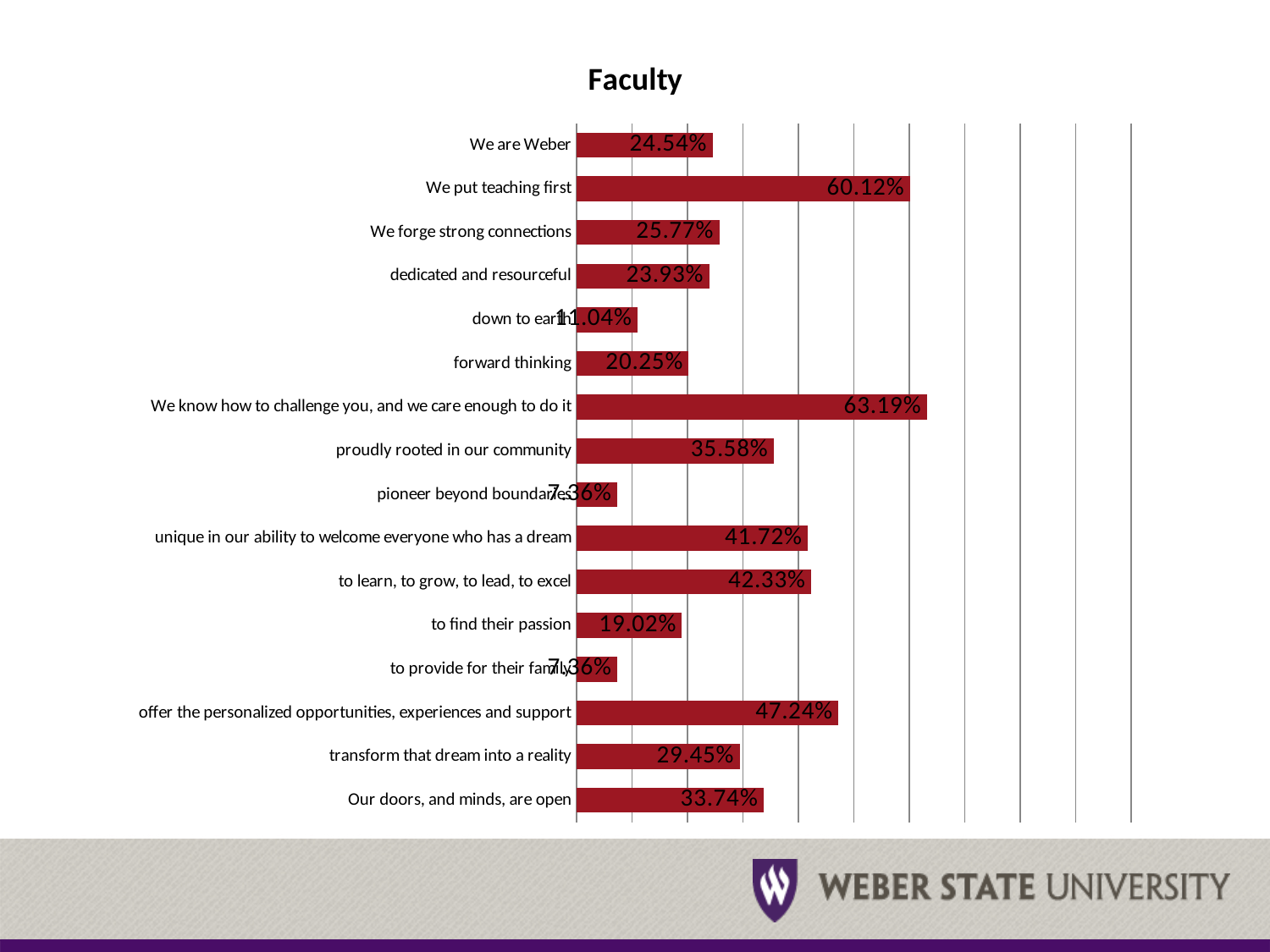
What is the difference between the values for "We put teaching first" and "We are Weber"? 35.58% What is the value for "offer the personalized opportunities, experiences and support"? 47.24% What is the value for "Our doors, and minds, are open"? 33.74% Which is larger, the value for "forward thinking" or the value for "to find their passion"? forward thinking What is the value for "We put teaching first"? 60.12% What is the difference between the values for "to learn, to grow, to lead, to excel" and "unique in our ability to welcome everyone who has a dream"? 0.61% Which category has the highest value? We know how to challenge you, and we care enough to do it How many categories are shown in the chart? 16 What kind of chart is shown on the slide? bar chart What is the title of the chart? Faculty What is the value for "proudly rooted in our community"? 35.58% Which is larger, the value for "transform that dream into a reality" or the value for "We forge strong connections"? transform that dream into a reality